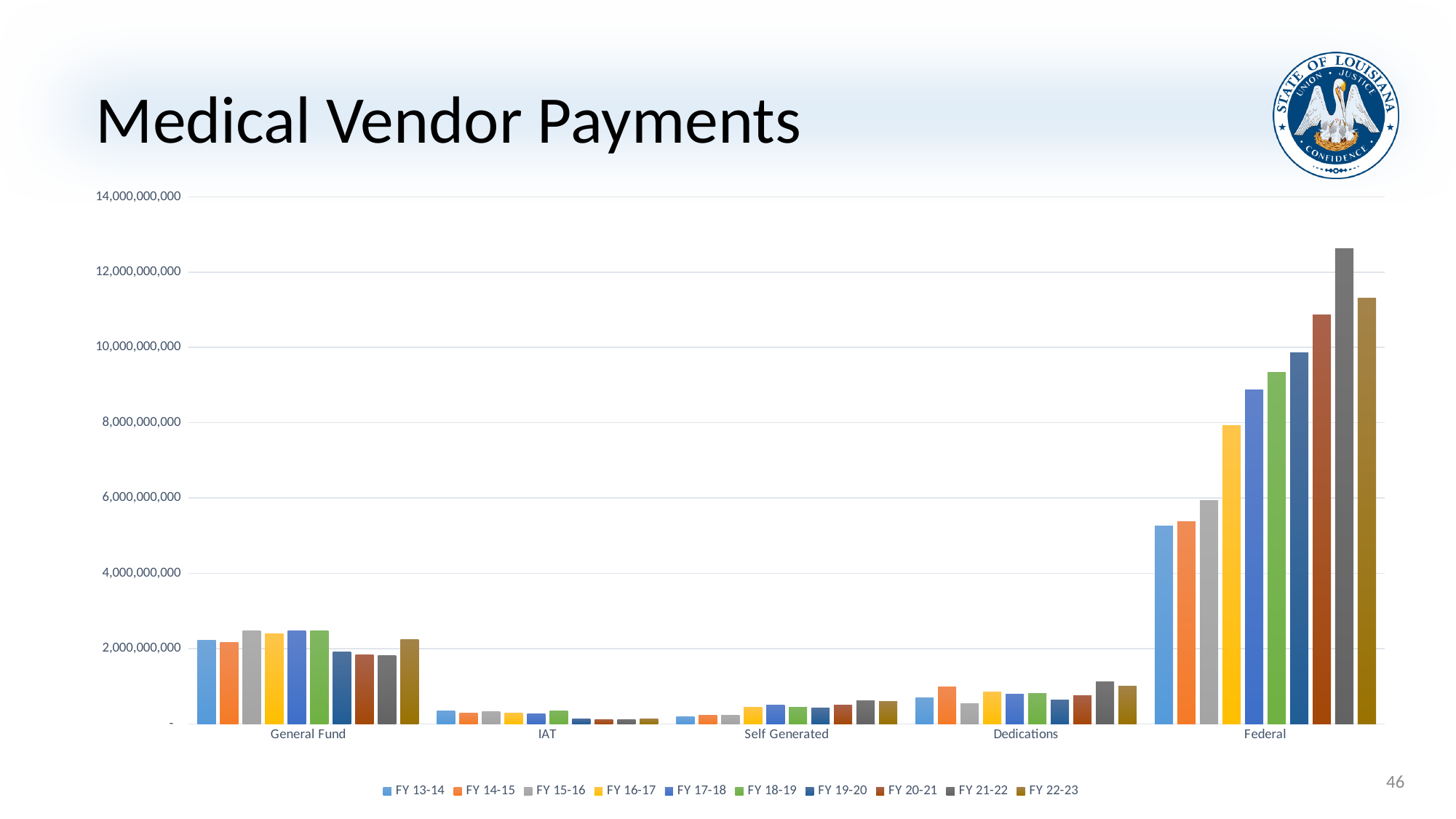
Is the Federal value for FY 22-23 greater or less than 12,000,000,000? less Which is larger in the General Fund category: FY 21-22 or FY 22-23? FY 22-23 Which funding category has the lowest bars overall? IAT How many fiscal-year series does the legend list? 10 Is the Federal value for FY 21-22 greater or less than 12,000,000,000? greater Which funding category has the highest bars overall? Federal Which is larger in the Federal category: FY 21-22 or FY 22-23? FY 21-22 Is the Federal value for FY 17-18 greater or less than 8,000,000,000? greater What is the title of the chart on the slide? Medical Vendor Payments How many funding categories are shown on the x axis? 5 What kind of chart is shown on the slide? bar chart Within the Federal category, which fiscal year has the tallest bar? FY 21-22